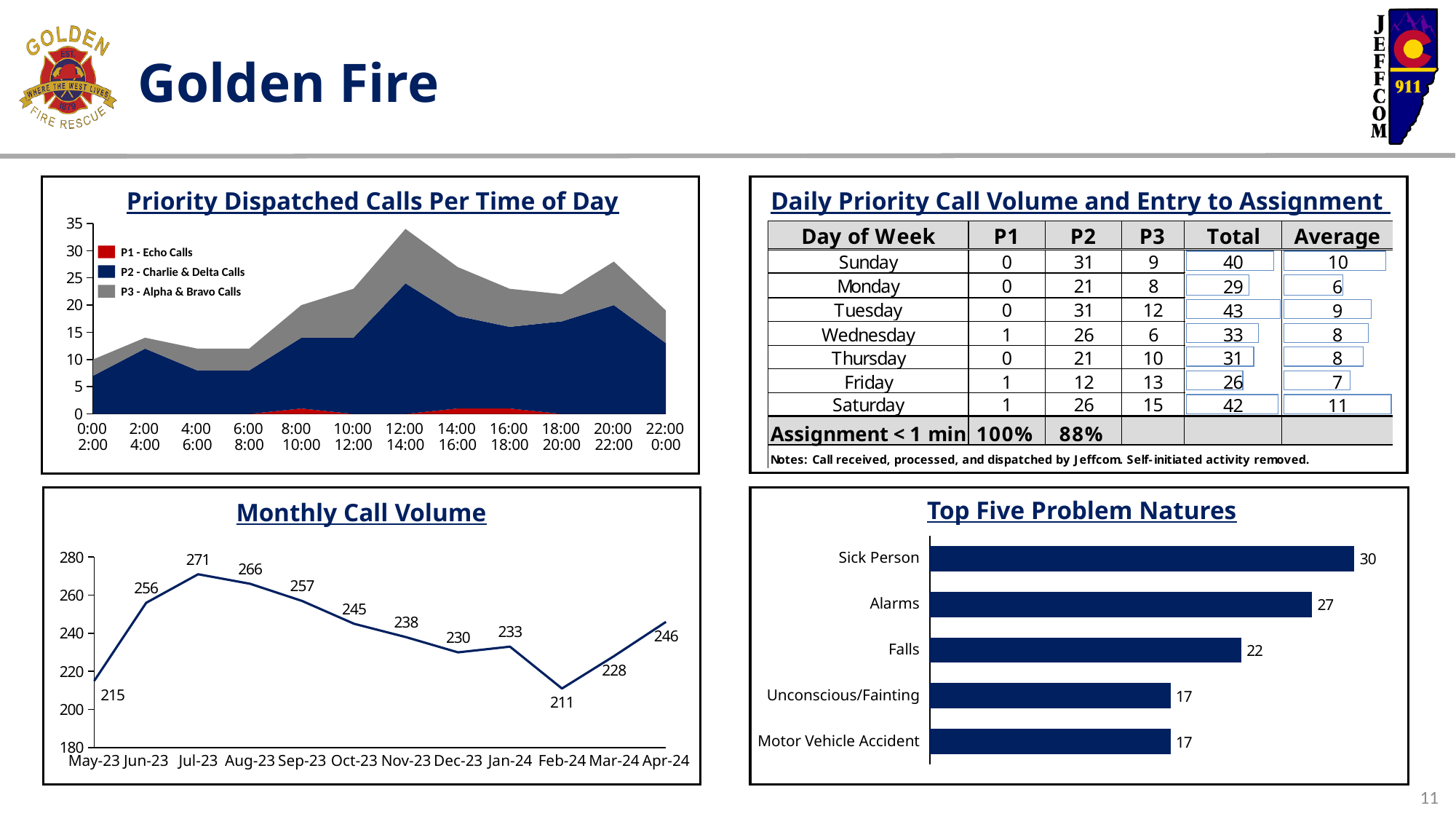
In the Top Five Problem Natures chart, what is the value for Falls? 22 In the Top Five Problem Natures chart, which problem nature has the highest value? Sick Person In the Monthly Call Volume chart, which month had the highest call volume? Jul-23 In the Monthly Call Volume chart, how many months are plotted? 12 What kind of chart is the Top Five Problem Natures chart? bar chart In the Monthly Call Volume chart, what is the difference between the call volumes for Jul-23 and Feb-24? 60 In the Top Five Problem Natures chart, which is larger, Alarms or Falls? Alarms In the Priority Dispatched Calls Per Time of Day chart, is the total stacked value for the 12:00-14:00 period greater or less than 30? greater In the Monthly Call Volume chart, which month had the lowest call volume? Feb-24 In the Monthly Call Volume chart, what was the call volume in Jul-23? 271 In the Monthly Call Volume chart, did call volume rise or fall from Jul-23 to Dec-23? fall How many series does the legend of the Priority Dispatched Calls Per Time of Day chart list? 3